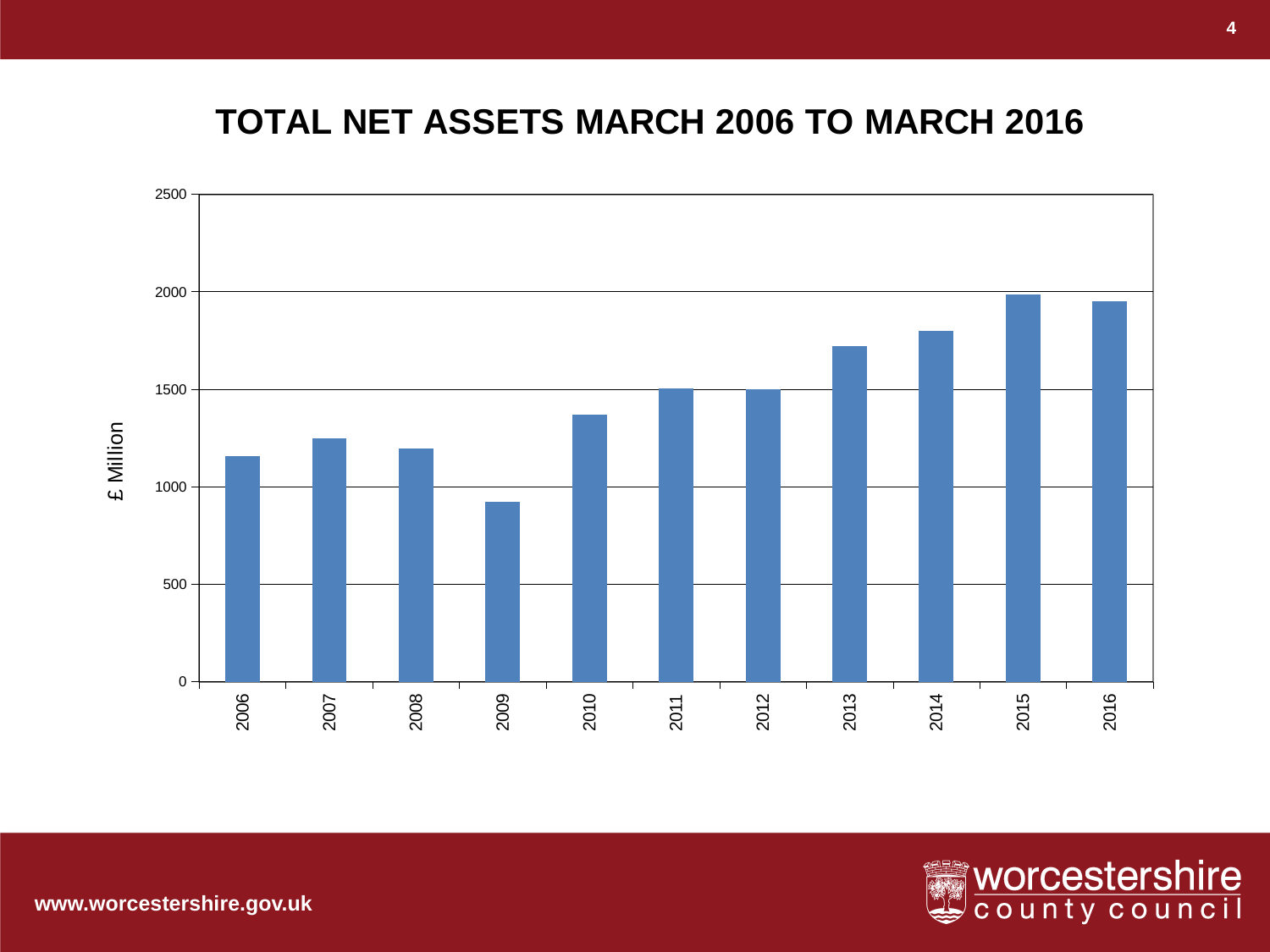
How many years are plotted on the x axis of the chart? 11 Which year has the highest total net assets in the chart? 2015 What is the label on the y axis of the chart? £ Million Which year has the larger value, 2010 or 2014? 2014 Overall, do the values rise or fall from 2006 to 2016? Rise Is the value for 2010 greater or less than 1500? less Which year has the lowest total net assets in the chart? 2009 Which year has the larger value, 2007 or 2009? 2007 Is the value for 2013 greater or less than 1500? greater What kind of chart is shown on the slide? Bar chart Is the value for 2009 greater or less than 1000? less